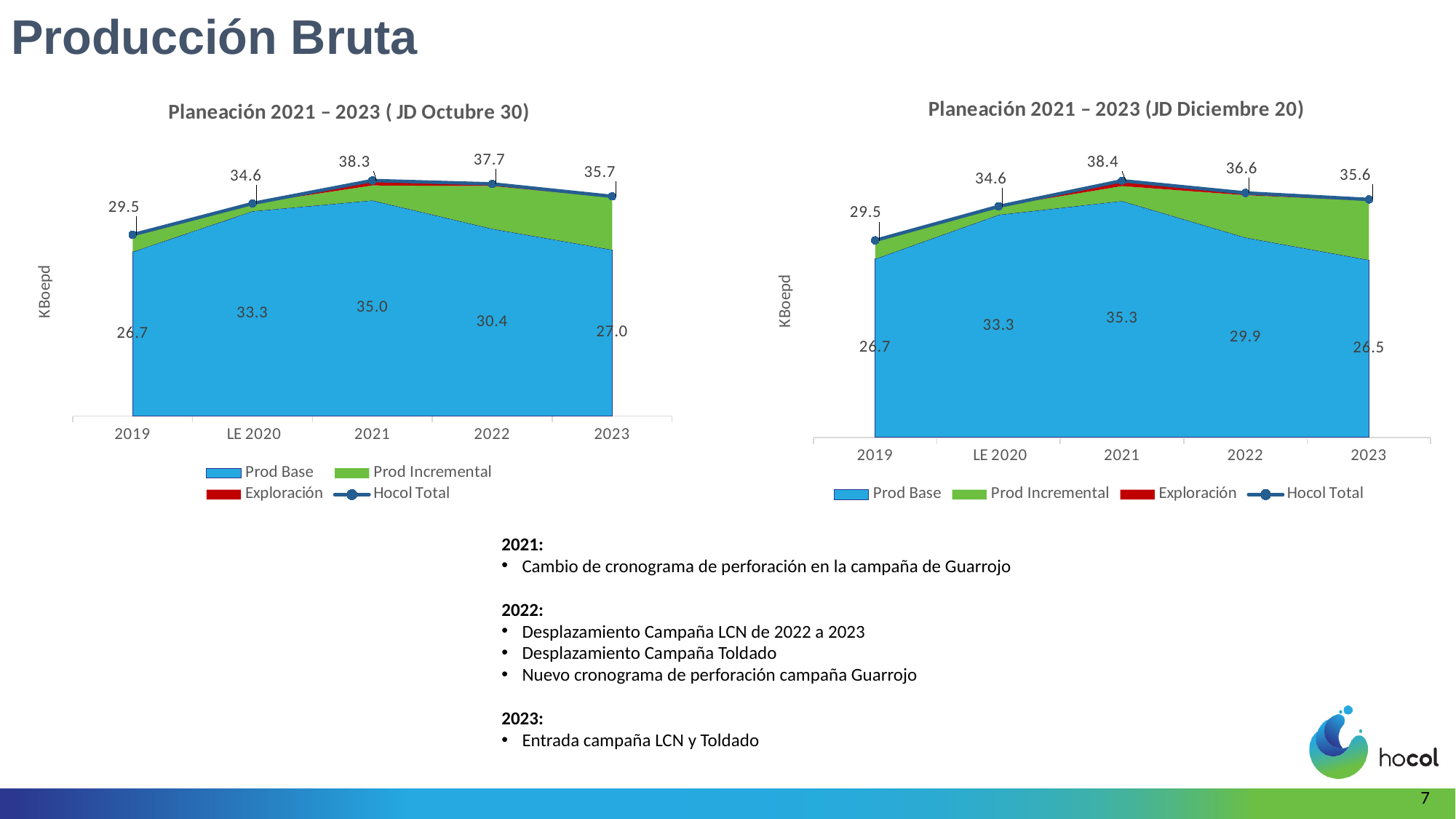
In the right chart (JD Diciembre 20), what is the Prod Base value for 2022? 29.9 In the left chart (JD Octubre 30), which year has the highest Hocol Total? 2021 In the left chart (JD Octubre 30), what is the Hocol Total value for 2021? 38.3 In the left chart (JD Octubre 30), what is the difference between the Hocol Total and Prod Base values for 2022? 7.3 Which is larger: the Hocol Total for 2022 in the left chart (JD Octubre 30) or in the right chart (JD Diciembre 20)? Left chart (JD Octubre 30), 37.7 How many years are shown on the x axis of the right chart (JD Diciembre 20)? 5 In the right chart (JD Diciembre 20), what is the Hocol Total value for 2023? 35.6 In the left chart (JD Octubre 30), does the Hocol Total rise or fall from 2021 to 2023? Fall How many series does the legend of the left chart (JD Octubre 30) list? 4 What is the y-axis label of the left chart (JD Octubre 30)? KBoepd What kind of chart is the right chart (JD Diciembre 20)? Stacked area chart with a line In the right chart (JD Diciembre 20), which year has the lowest Prod Base? 2023